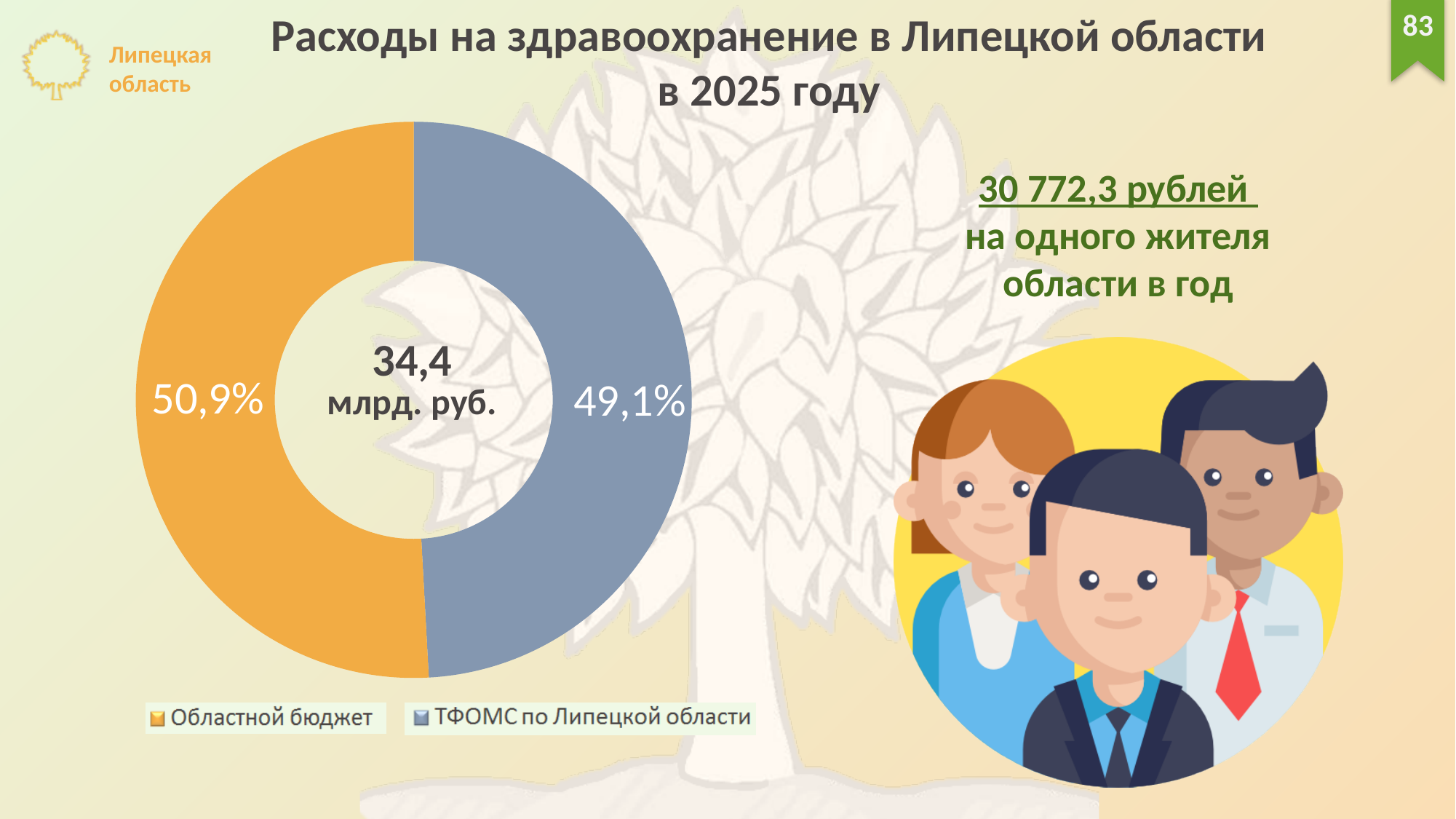
What total amount is shown in the centre of the chart? 34,4 млрд. руб. Is the share for ТФОМС по Липецкой области greater or less than 50%? less Which colour represents Областной бюджет in the chart? Orange What is the title of the chart? Расходы на здравоохранение в Липецкой области в 2025 году What is the difference in percentage points between the Областной бюджет share and the ТФОМС по Липецкой области share? 1,8 What share of healthcare expenditure comes from ТФОМС по Липецкой области? 49,1% Which category has the smallest share in the chart? ТФОМС по Липецкой области What type of chart is shown on the slide? Doughnut (pie) chart How many categories does the chart show? 2 Which source has the larger share: Областной бюджет or ТФОМС по Липецкой области? Областной бюджет What share of healthcare expenditure comes from Областной бюджет? 50,9%